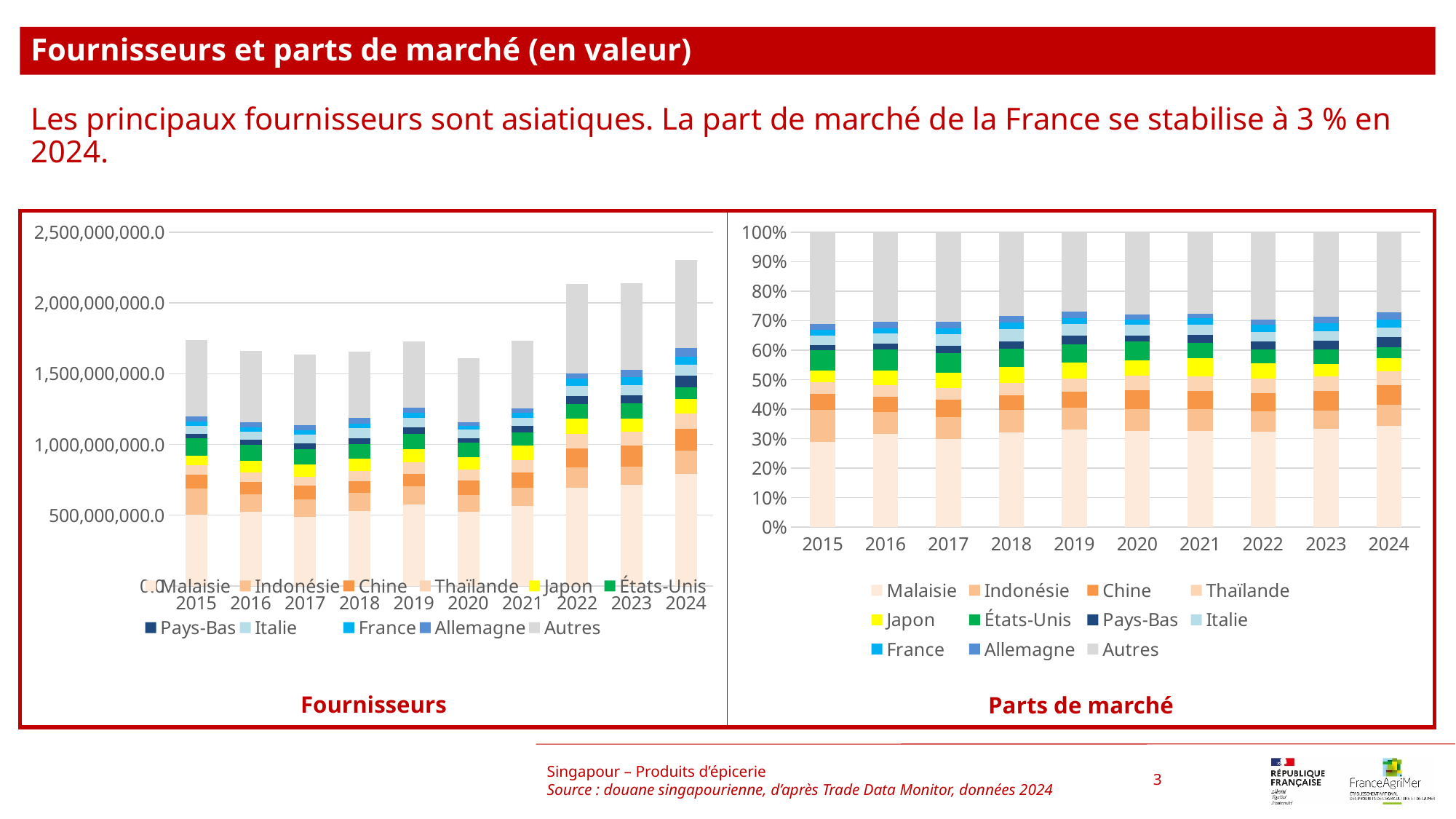
In the 'Fournisseurs' chart, which year has the highest total bar? 2024 In the 'Parts de marché' chart, which series is shown in grey at the top of each bar? Autres In the 'Fournisseurs' chart, is the total for 2024 greater or less than 2,000,000,000.0? greater How many series does the legend of the 'Parts de marché' chart list? 11 In the 'Parts de marché' chart, is the Malaisie share in 2024 greater or less than 30%? greater In the 'Fournisseurs' chart, is the total for 2015 greater or less than 1,500,000,000.0? greater In the 'Fournisseurs' chart, which total bar is larger, 2022 or 2016? 2022 What kind of chart is the 'Fournisseurs' chart on the left? Stacked bar chart How many years are shown on the x axis of the 'Fournisseurs' chart? 10 What kind of chart is the 'Parts de marché' chart on the right? Stacked bar chart In the 'Parts de marché' chart, what is the first year shown on the x axis? 2015